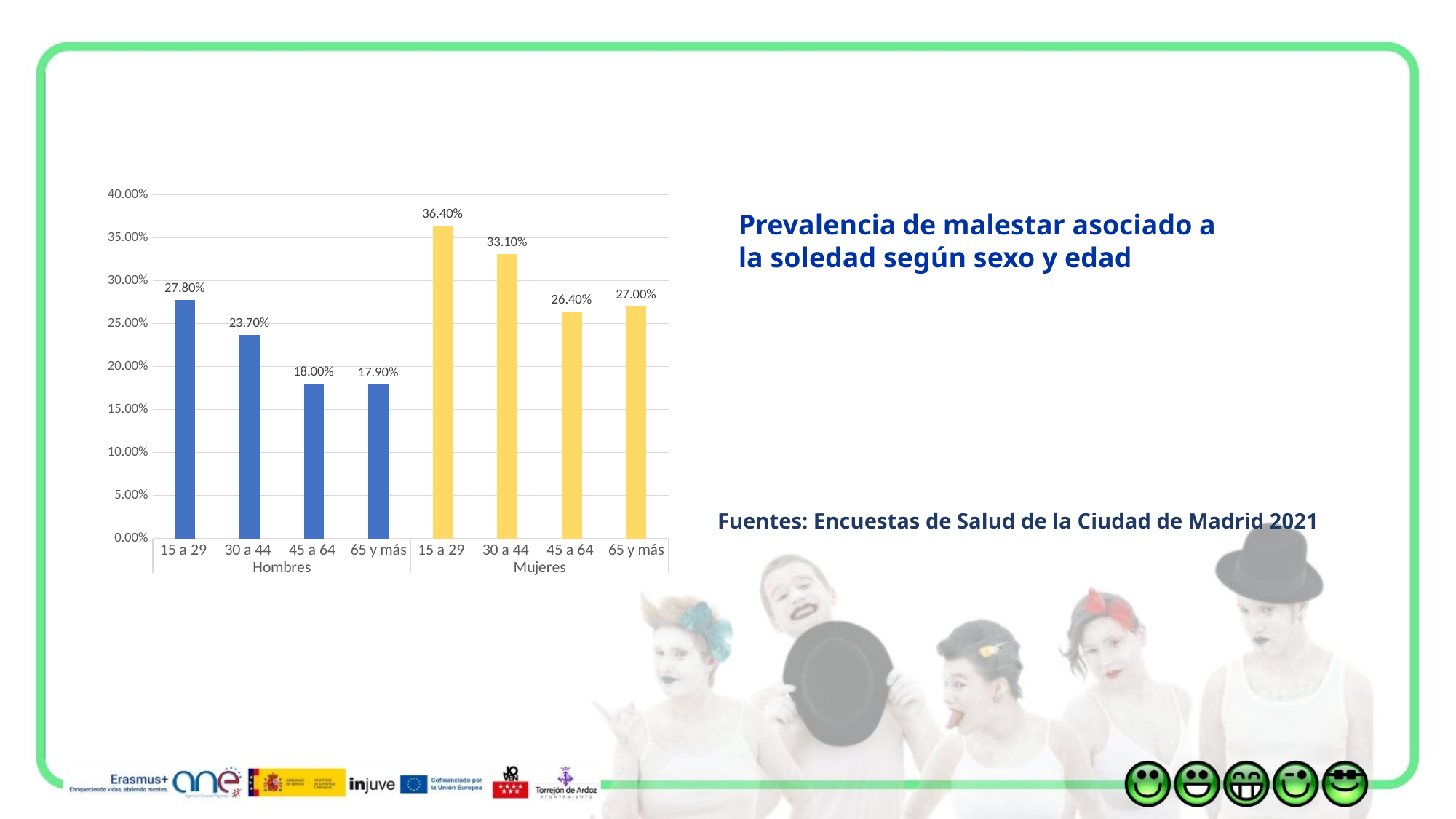
What is the value for Mujeres aged 30 a 44? 33.10% What is the value for Hombres aged 15 a 29? 27.80% Is the value for Mujeres 30 a 44 greater or less than 30.00%? greater What kind of chart is shown on the slide? Bar chart How many bars are plotted on the chart? 8 What is the value for Hombres aged 65 y más? 17.90% What is the difference between the values for Mujeres 45 a 64 and Hombres 45 a 64? 8.40% What is the difference between the values for Mujeres 15 a 29 and Hombres 15 a 29? 8.60% Which group has the highest value on the chart? Mujeres 15 a 29 Which is larger, the value for Mujeres 65 y más or Mujeres 45 a 64? Mujeres 65 y más Which group has the lowest value on the chart? Hombres 65 y más What is the title text shown next to the chart? Prevalencia de malestar asociado a la soledad según sexo y edad